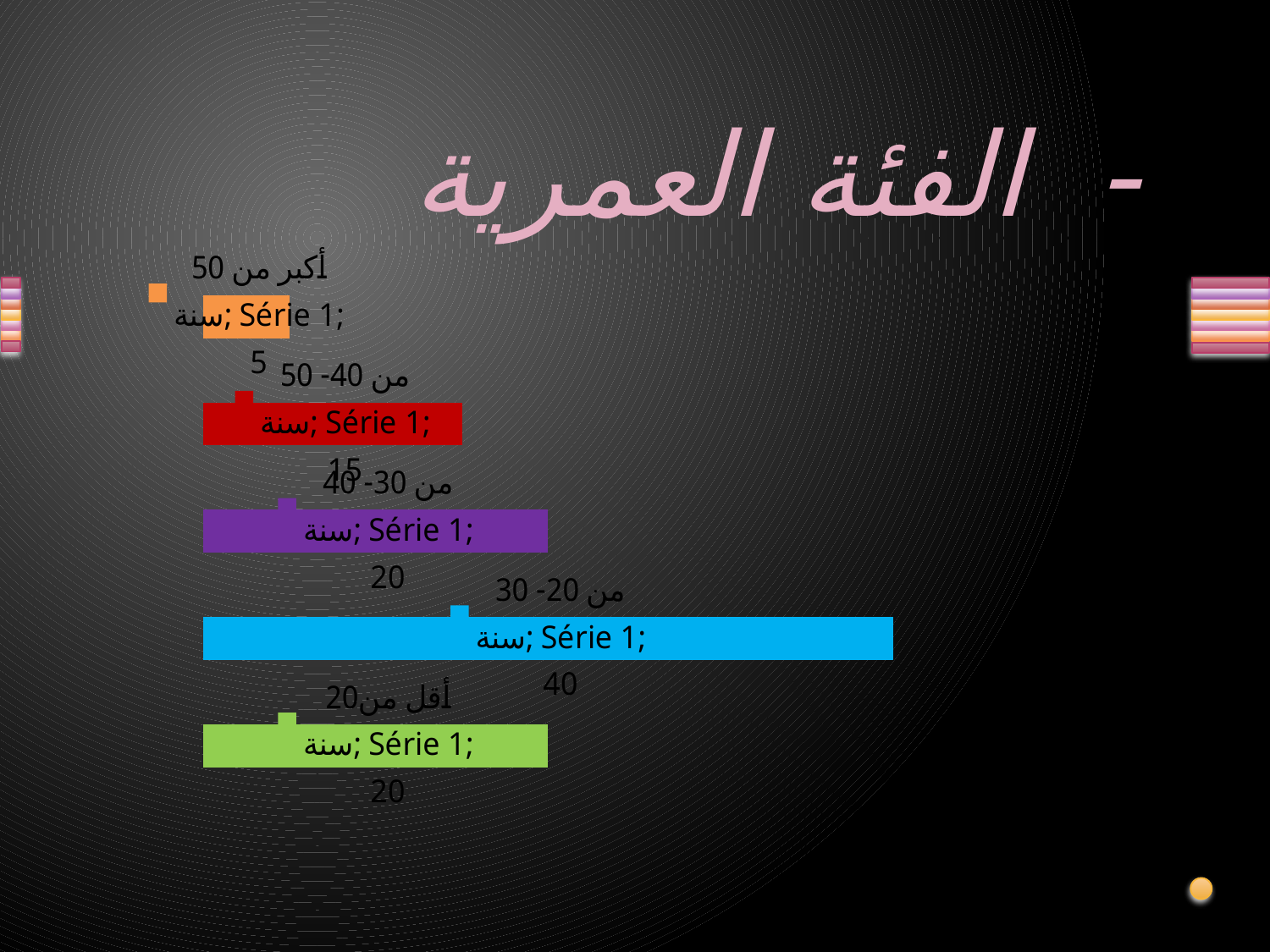
What is the title of the chart? الفئة العمرية How many categories (bars) does the chart show? 5 What is the value for the category 'أكبر من 50 سنة'? 5 What kind of chart is shown on the slide? bar chart Which category has the lowest value? أكبر من 50 سنة What is the value for the category 'من 20-30 سنة'? 40 What is the difference between the values for 'من 20-30 سنة' and 'من 40-50 سنة'? 25 Which category has the highest value? من 20-30 سنة What is the value for the category 'أقل من 20 سنة'? 20 Which is larger, the value for 'من 30-40 سنة' or the value for 'أكبر من 50 سنة'? من 30-40 سنة What is the value for the category 'من 40-50 سنة'? 15 What is the name of the series shown in the data labels? Série 1